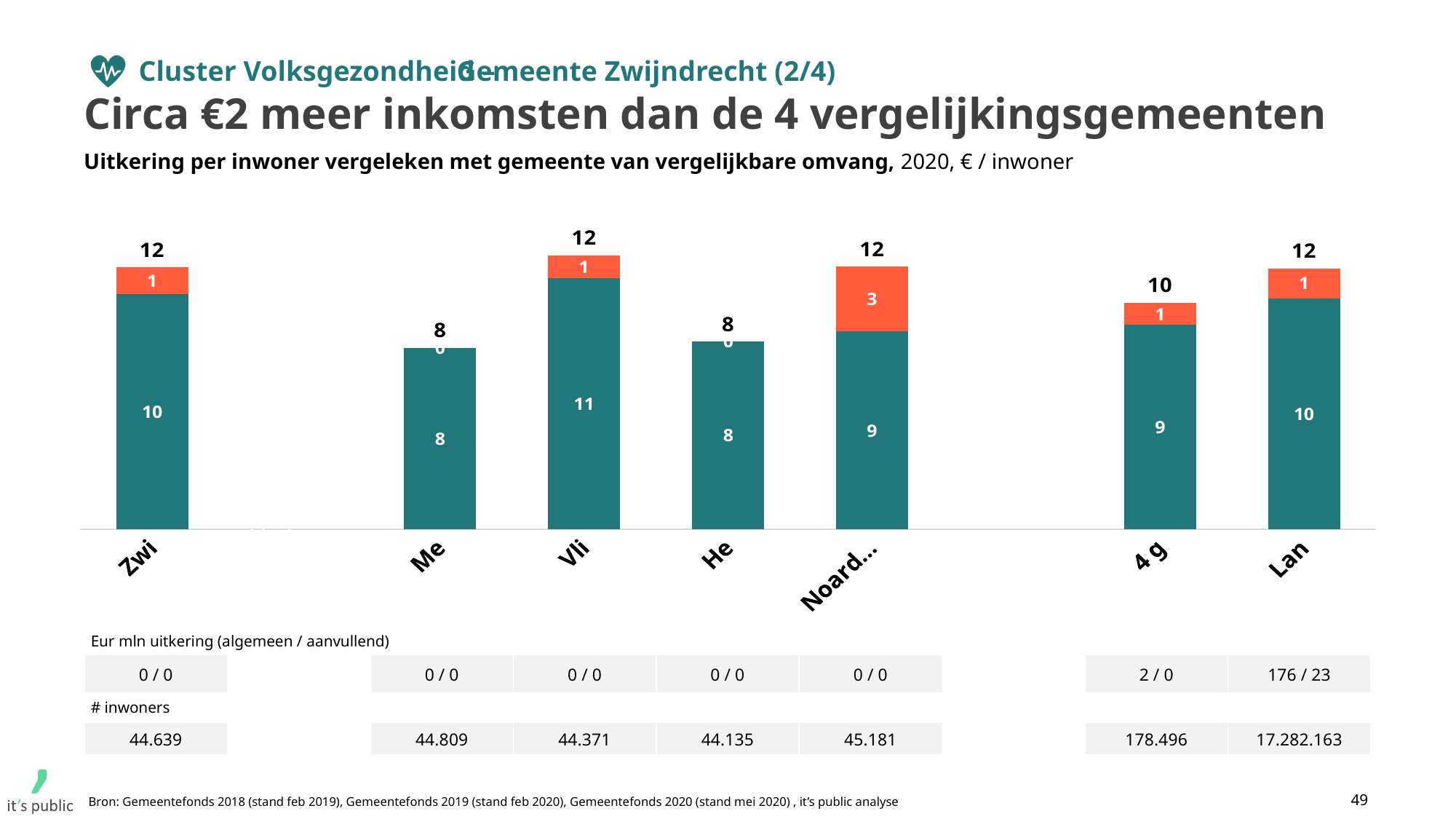
What is the value of the teal (lower) segment of the bar for Vli? 11 What is the total value shown above the bar for Zwi? 12 Which category has the lowest total value? Me and He (both 8) How many categories are shown on the x axis? 7 What is the total value shown above the bar for 4 g? 10 What is the value of the orange segment for Me? 0 What kind of chart is shown on the slide? Stacked bar chart What is the difference between the total for Zwi and the total for 4 g? 2 What unit is stated in the chart subtitle? € / inwoner Which is larger, the total for Vli or the total for He? Vli What is the value of the orange (upper) segment of the bar for Noard...? 3